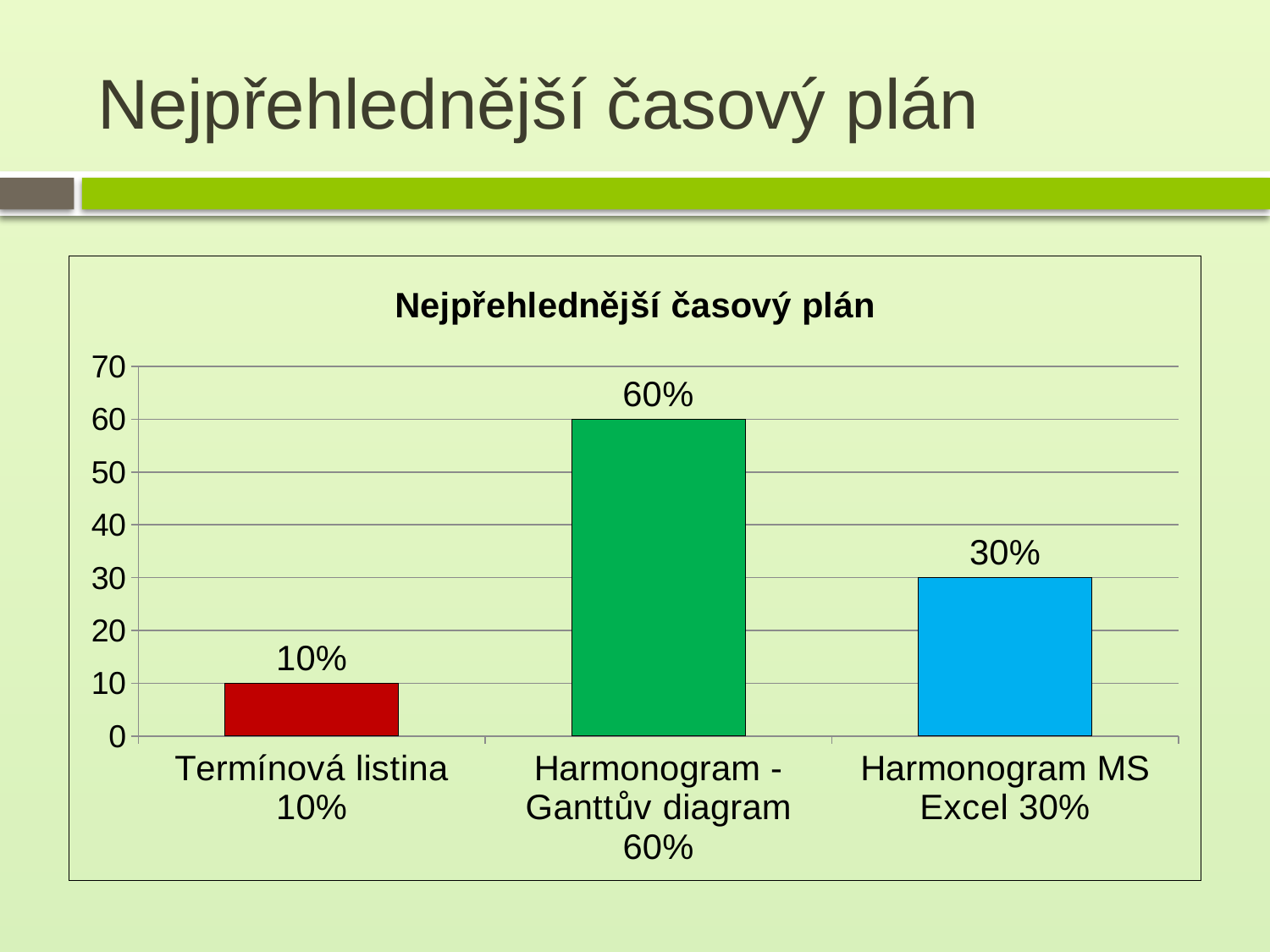
What is the value for Harmonogram MS Excel? 30% Which is larger, the value for Harmonogram MS Excel or the value for Termínová listina? Harmonogram MS Excel Which category has the highest value? Harmonogram - Ganttův diagram Which category has the lowest value? Termínová listina What is the value for Termínová listina? 10% What is the value for Harmonogram - Ganttův diagram? 60% What is the title of the chart? Nejpřehlednější časový plán Is the value for Harmonogram - Ganttův diagram greater or less than 50? greater What kind of chart is shown on the slide? bar chart How many categories are shown in the chart? 3 What is the difference between the values for Harmonogram - Ganttův diagram and Harmonogram MS Excel? 30% What is the difference between the values for Harmonogram MS Excel and Termínová listina? 20%